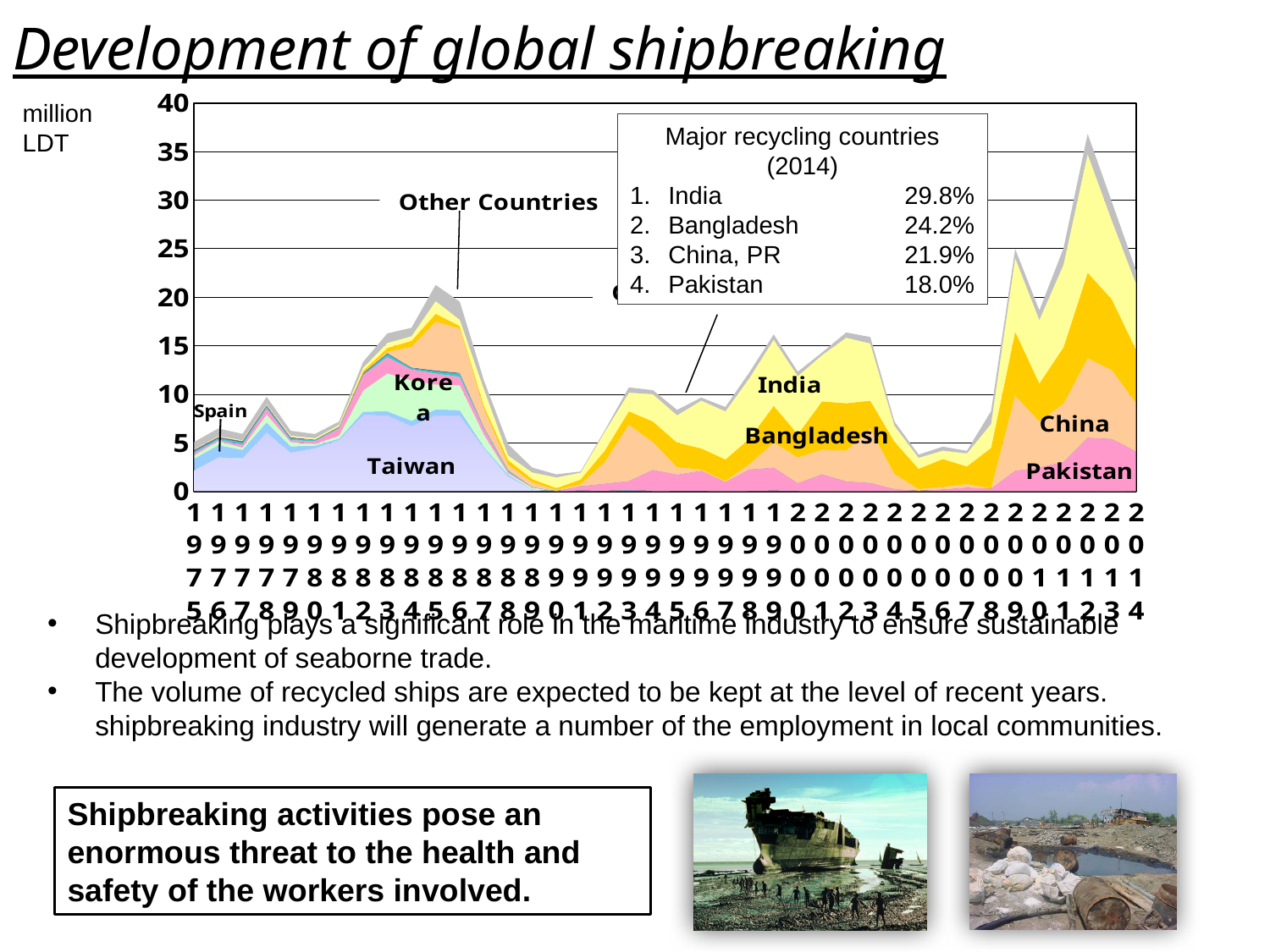
By how many percentage points does India's 2014 share exceed Bangladesh's in the box on the chart? 5.6 Is the total shipbreaking volume in 2012 greater or less than 30 million LDT? greater In which year does the total shipbreaking volume reach its highest peak on the chart? 2012 Which has the larger 2014 share in the box on the chart, China, PR or Pakistan? China, PR According to the box on the chart, what share of major recycling did India have in 2014? 29.8% Is the total shipbreaking volume in 1998 greater or less than 5 million LDT? greater What unit is the vertical axis of the chart measured in? million LDT According to the box on the chart, what share of major recycling did Pakistan have in 2014? 18.0% Does the total shipbreaking volume rise or fall between 2009 and 2012? rise What kind of chart is shown on the slide? Area chart Which country is listed first among the major recycling countries in 2014? India According to the box on the chart, what share of major recycling did Bangladesh have in 2014? 24.2%